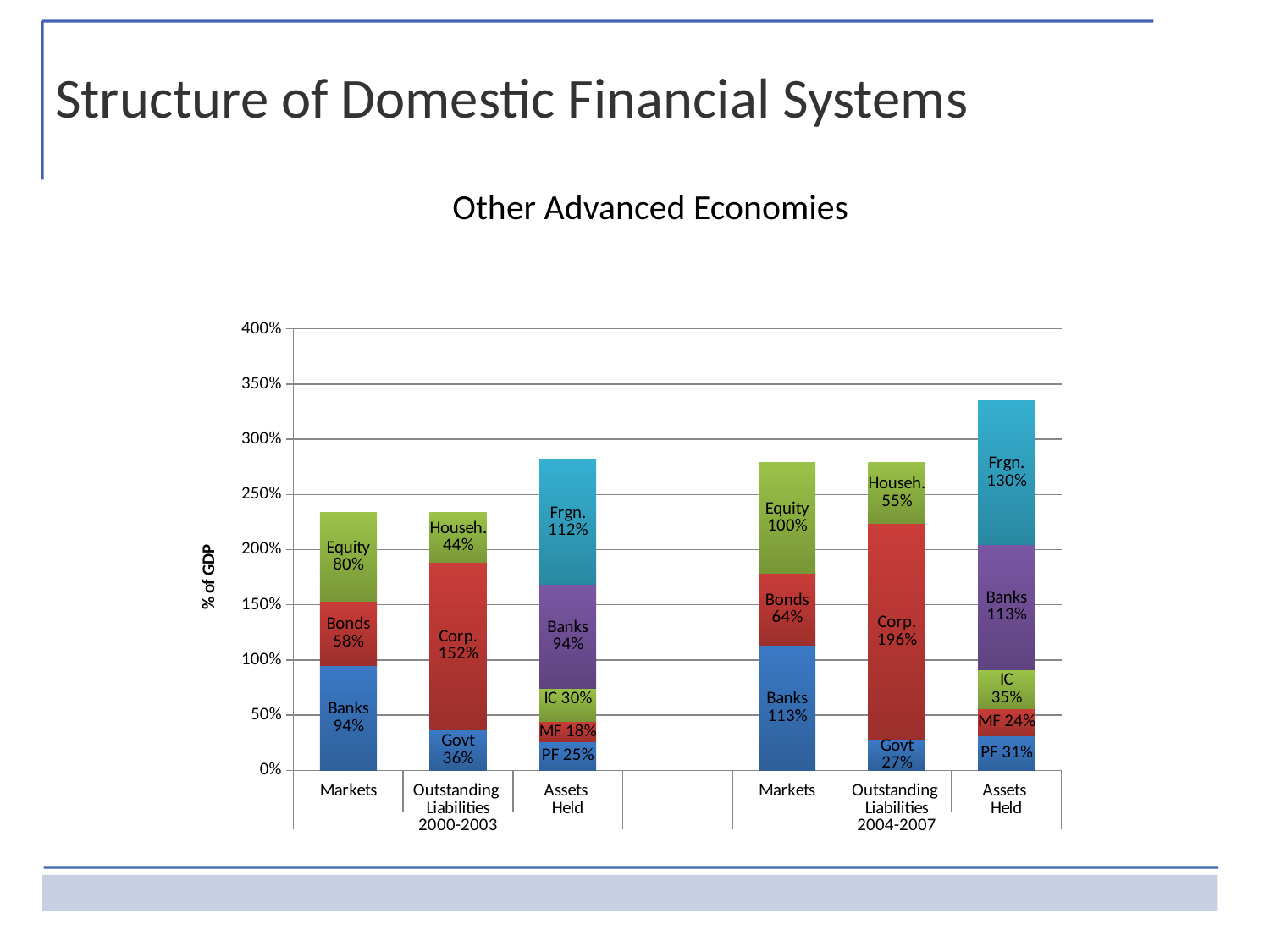
How many segments make up the Assets Held bar for 2000-2003? 5 Is the total of the Assets Held bar for 2004-2007 greater or less than 300%? greater What is the value of the Banks segment in the Markets bar for 2000-2003? 94% What is the value of the Equity segment in the Markets bar for 2000-2003? 80% What is the value of the Frgn. segment in the Assets Held bar for 2004-2007? 130% What is the total of the Markets bar for 2004-2007? 277% How much larger is the Equity segment in the Markets bar for 2004-2007 than in the Markets bar for 2000-2003? 20% What is the title of the chart? Other Advanced Economies What is the value of the Corp. segment in the Outstanding Liabilities bar for 2004-2007? 196% What is the label on the vertical axis of the chart? % of GDP Which is larger: the Corp. segment in Outstanding Liabilities for 2000-2003 or for 2004-2007? 2004-2007 What kind of chart is shown on the slide? Stacked bar chart